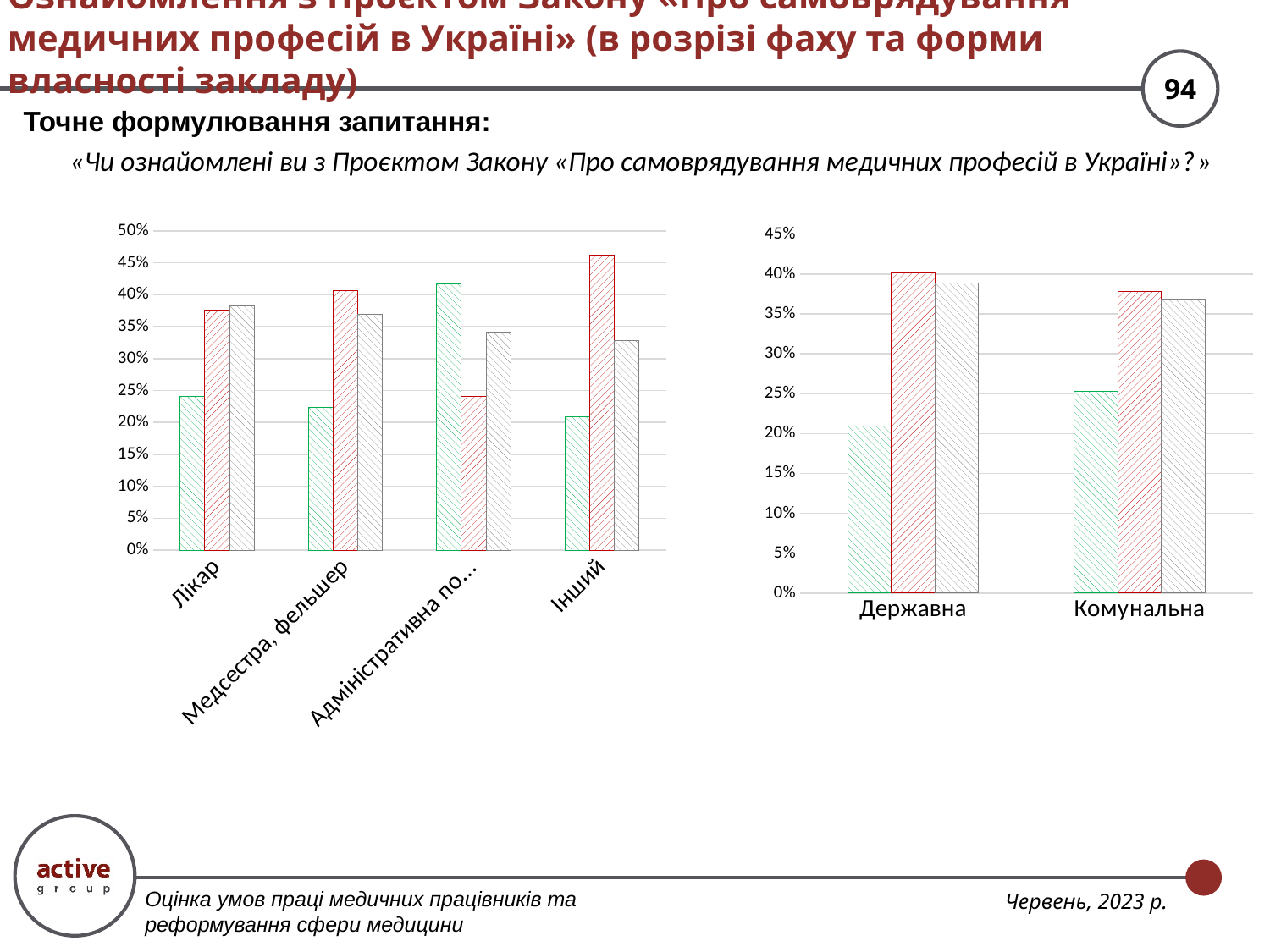
In the right chart, is the green hatched bar for Державна greater or less than 25%? less In the left chart, is the green hatched bar for Лікар greater or less than 20%? greater In the left chart, which category has the highest red hatched bar? Інший In the left chart, for Лікар, is the green hatched bar or the red hatched bar larger? red hatched bar In the left chart, is the red hatched bar for Інший greater or less than 40%? greater In the left chart, how many bars are plotted for each category? 3 What kind of chart is the left chart on the slide? bar chart How many categories are shown on the x axis of the right chart? 2 In the right chart, is the green hatched bar larger for Державна or for Комунальна? Комунальна In the left chart, which category has the highest green hatched bar? Адміністративна по... How many categories are shown on the x axis of the left chart? 4